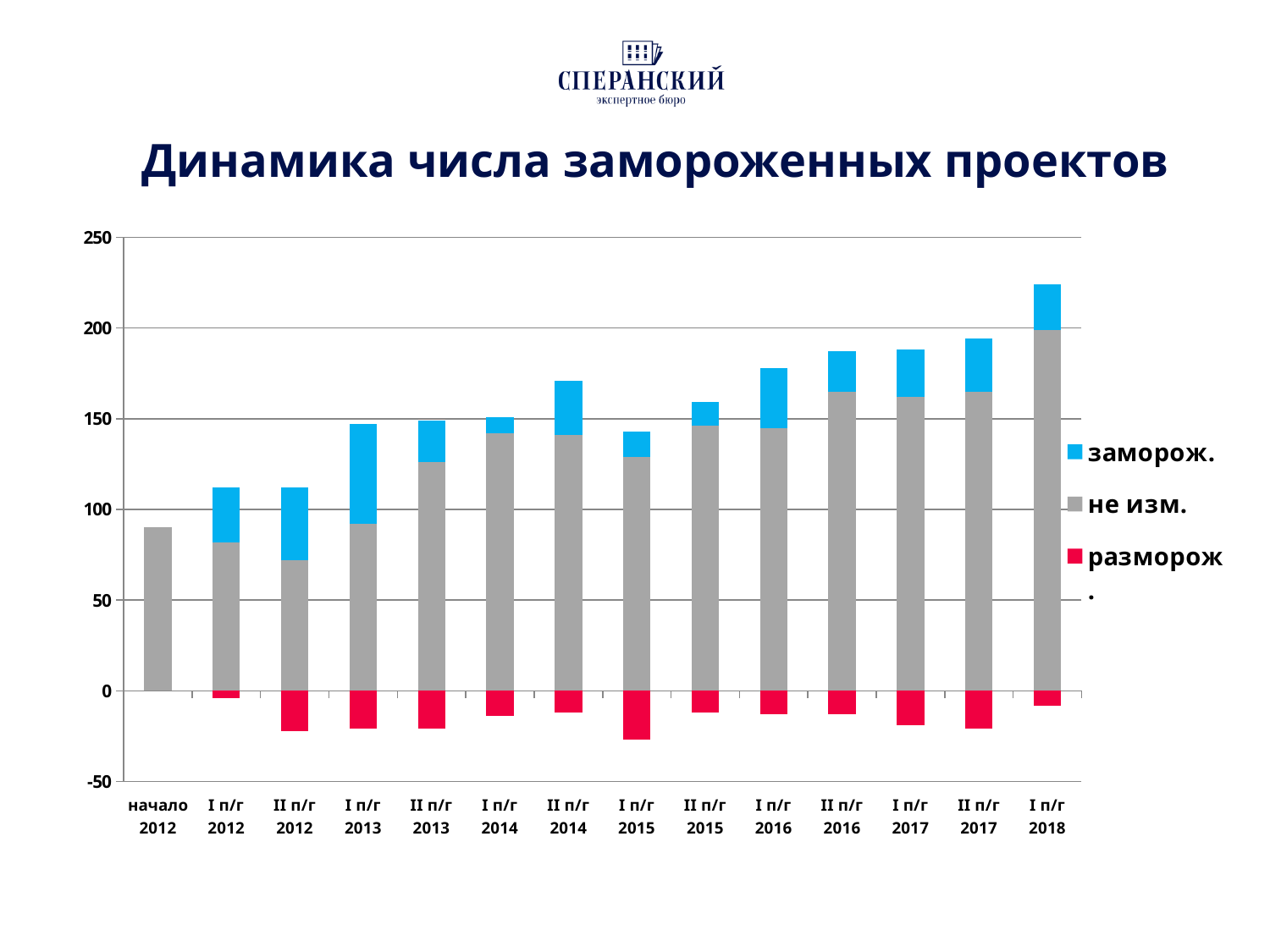
Is the top of the stacked bar for I п/г 2018 greater or less than 200? greater Which category has the shortest stacked bar above zero? начало 2012 Which is larger: the 'не изм.' segment for II п/г 2016 or for I п/г 2014? II п/г 2016 How many categories are shown on the x axis? 14 Do the heights of the stacked bars above zero generally rise or fall from начало 2012 to I п/г 2018? rise Which category has the tallest stacked bar above zero? I п/г 2018 How many series does the legend list? 3 What is the title of the chart? Динамика числа замороженных проектов Which colour represents the 'разморож.' series in the legend? red Is the top of the stacked bar for I п/г 2015 greater or less than 150? less What kind of chart is shown on the slide? stacked bar chart Is the value of the 'не изм.' segment for I п/г 2018 greater or less than 150? greater